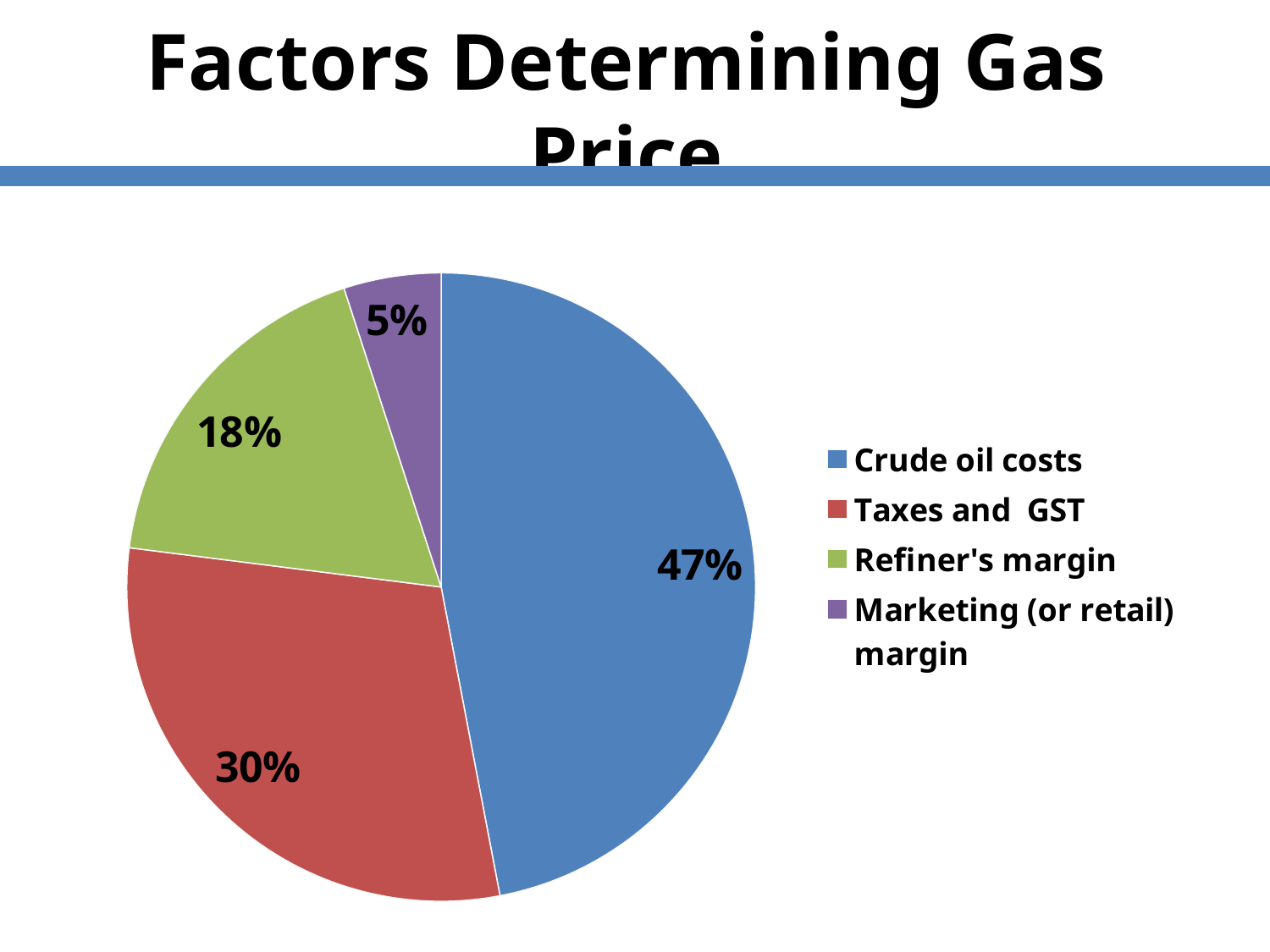
What kind of chart is shown on the slide? Pie chart What is the value shown for Marketing (or retail) margin? 5% What is the difference between the Crude oil costs share and the Taxes and GST share? 17% What colour is the slice for Refiner's margin? Green Which is larger, Taxes and GST or Refiner's margin? Taxes and GST How many categories are shown in the pie chart? 4 Which category has the largest slice of the pie? Crude oil costs What is the value shown for Taxes and GST? 30% Which category has the smallest slice of the pie? Marketing (or retail) margin What is the difference between the Refiner's margin share and the Marketing (or retail) margin share? 13% What share of the pie does Crude oil costs account for? 47% What is the value shown for Refiner's margin? 18%